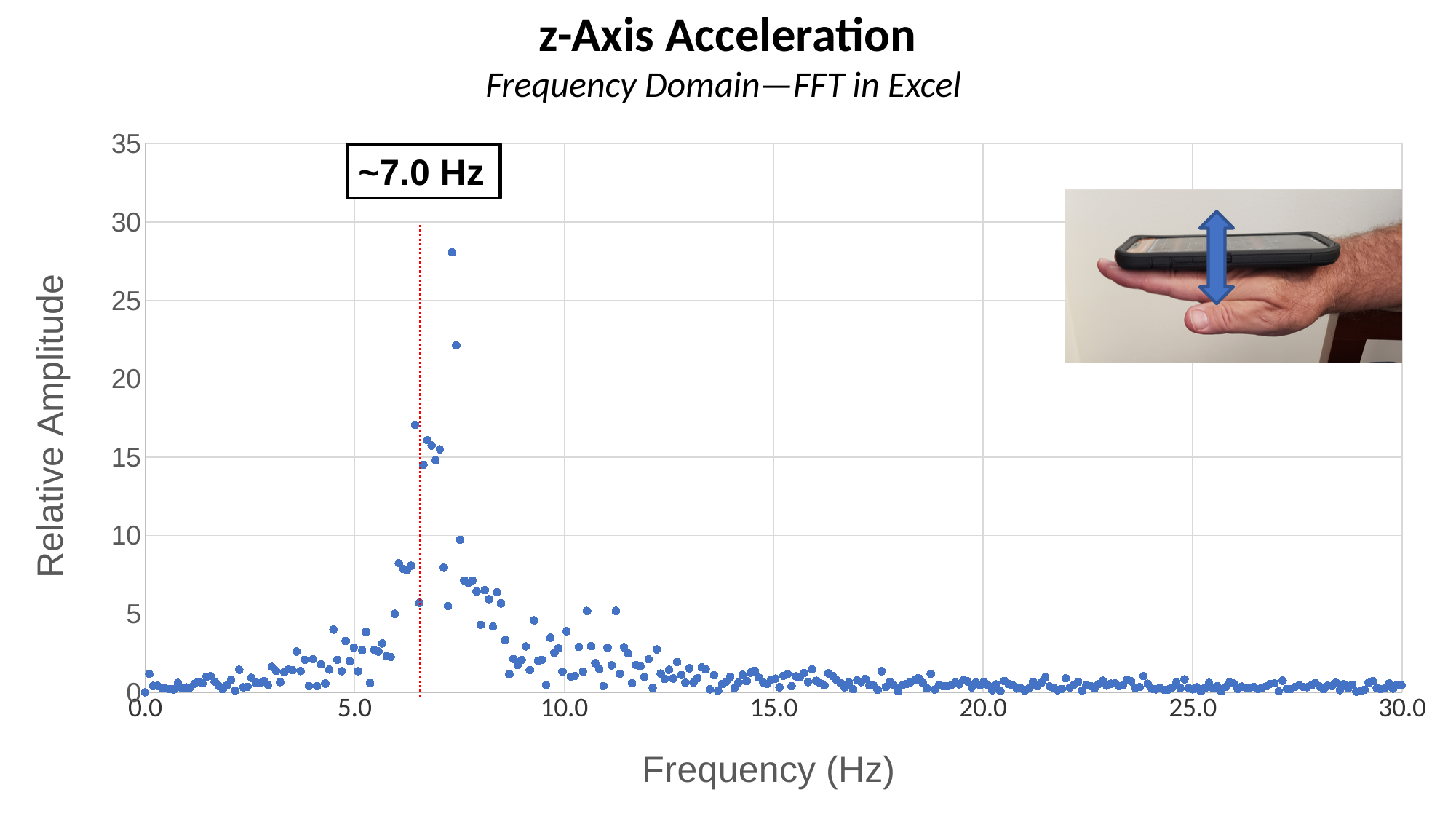
What kind of chart is shown on the slide? scatter chart What label is shown on the x axis of the chart? Frequency (Hz) Are the relative amplitude values at frequencies above 20.0 Hz greater or less than 5? less What is the highest value shown on the y axis of the chart? 35 What is the title of the chart? z-Axis Acceleration According to the annotation on the chart, at approximately what frequency does the peak occur? ~7.0 Hz Is the highest plotted relative amplitude greater or less than 30? less Is the highest plotted relative amplitude greater or less than 25? greater Between 0.0 Hz and the peak near 7 Hz, do the relative amplitude values generally rise or fall as frequency increases? rise Is the relative amplitude higher at the peak near 7 Hz or at 15.0 Hz? at the peak near 7 Hz After the peak near 7 Hz, do the relative amplitude values generally rise or fall as frequency increases? fall